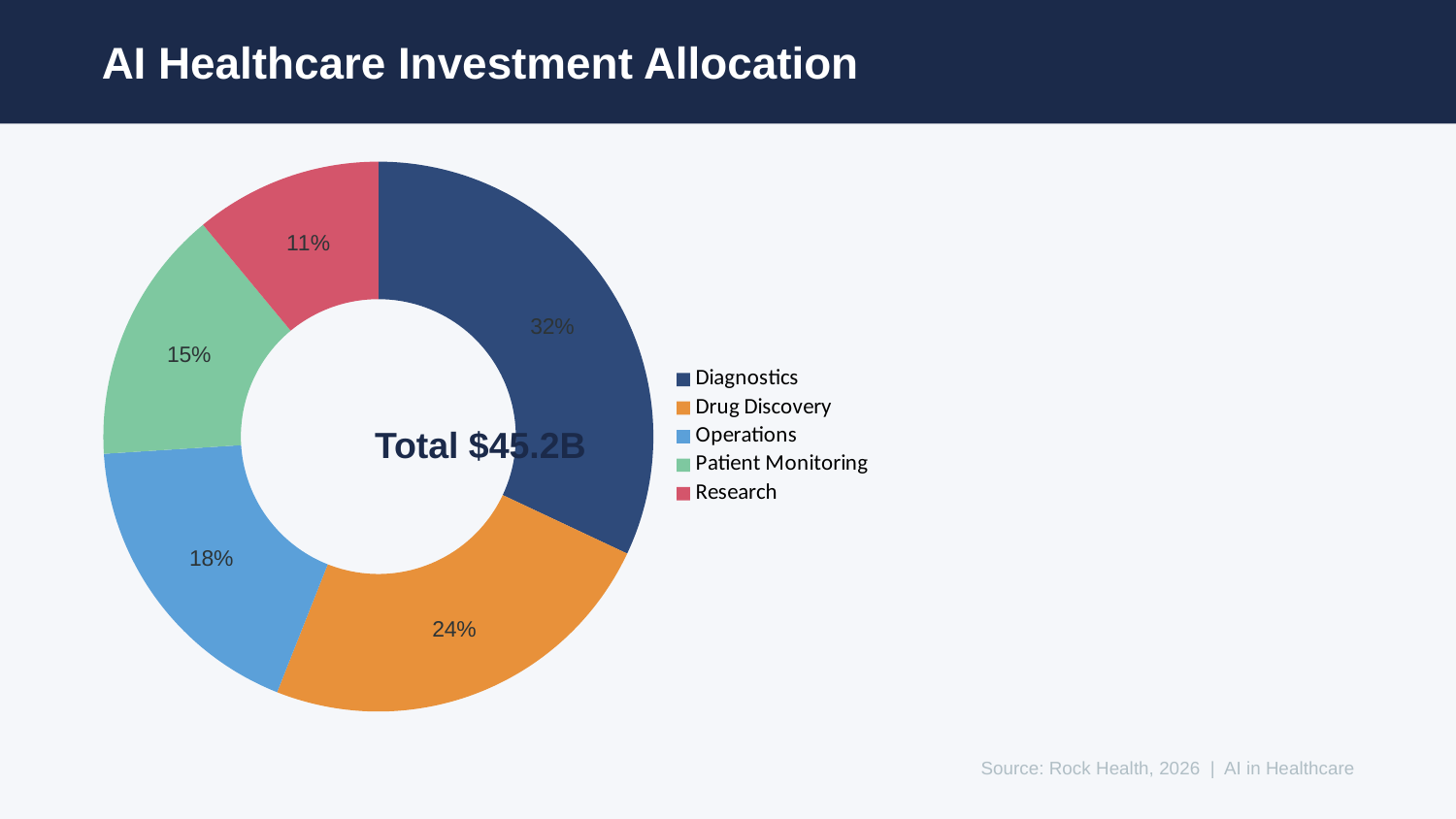
Which category receives the smallest share of investment? Research What share does Operations receive? 18% What percentage is allocated to Patient Monitoring? 15% What percentage of the allocation is Drug Discovery? 24% What share of AI healthcare investment goes to Diagnostics? 32% How many categories are shown in the chart? 5 What kind of chart is shown on the slide? Pie chart (donut) What total investment amount is shown in the centre of the chart? $45.2B Which category receives the largest share of investment? Diagnostics Which has a larger share, Operations or Patient Monitoring? Operations What share of the allocation goes to Research? 11% How many percentage points larger is the Diagnostics share than the Drug Discovery share? 8